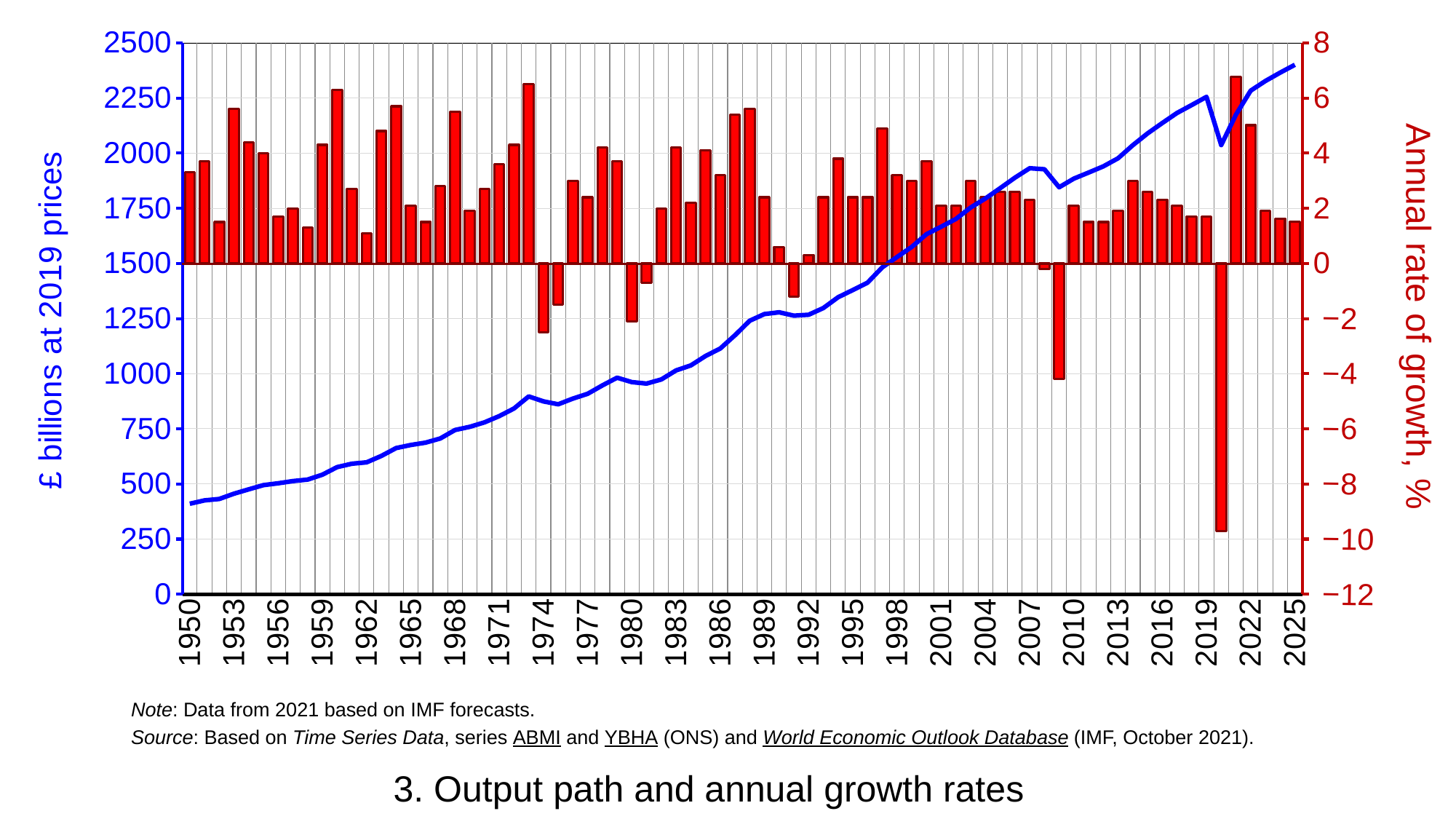
Does the output line (£ billions at 2019 prices) generally rise or fall from 1950 to 2025? rise Which year has the larger annual rate of growth, 2020 or 2021? 2021 Is the annual rate of growth for 1974 greater or less than 0? less Is the output value (£ billions at 2019 prices) for 1950 greater or less than 500? less Is the output value (£ billions at 2019 prices) for 1975 greater or less than 1000? less What is the label on the right-hand vertical axis? Annual rate of growth, % What kind of chart is shown on the slide? A combined bar and line chart Which year has the lowest annual rate of growth? 2020 Which year has the larger annual rate of growth, 1973 or 1974? 1973